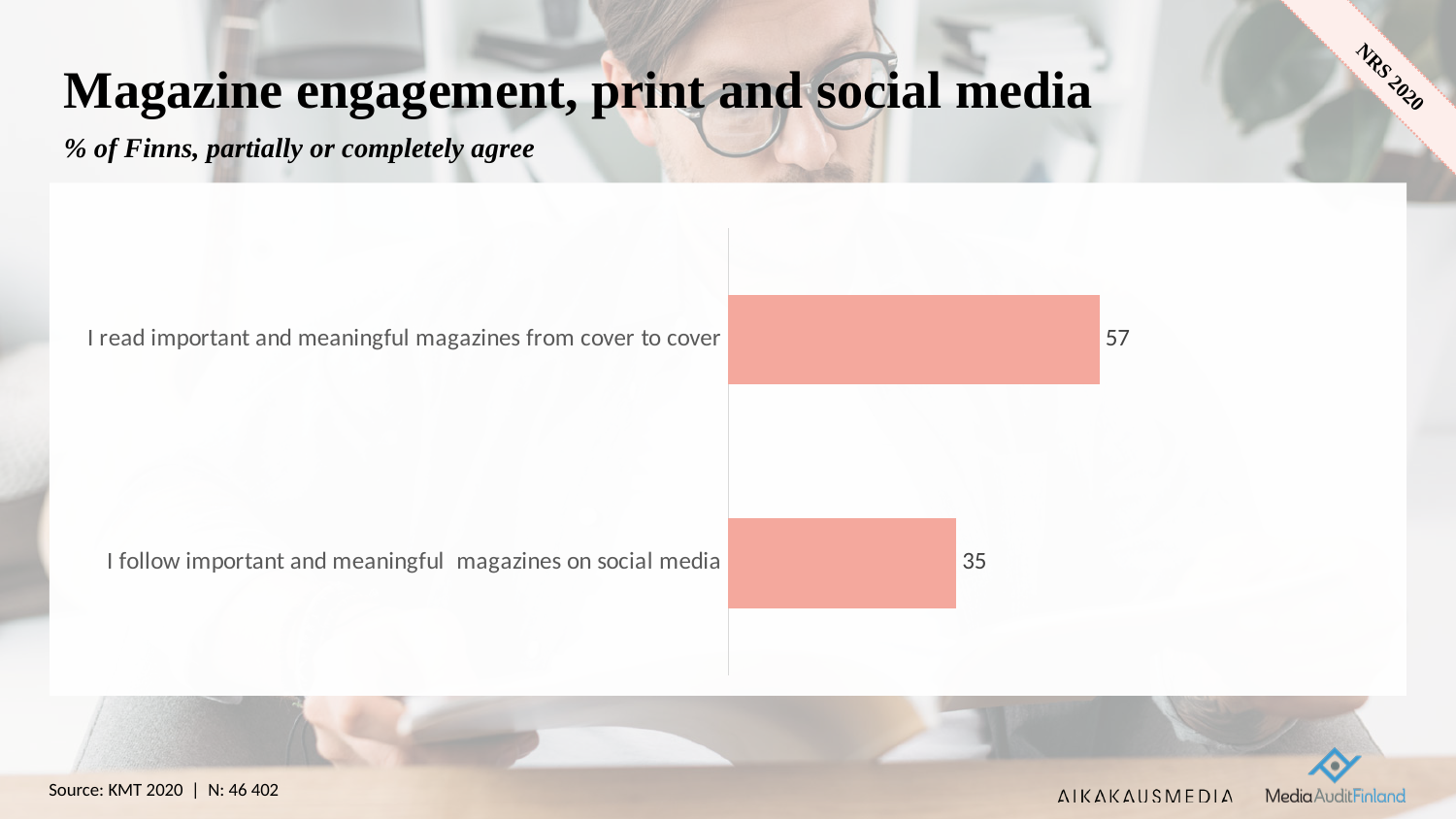
What is the title of the slide? Magazine engagement, print and social media What percentage of Finns agree with "I follow important and meaningful magazines on social media"? 35 Which statement has the lower value? I follow important and meaningful magazines on social media How many categories are shown in the chart? 2 What kind of chart is shown on the slide? bar chart What percentage of Finns agree with "I read important and meaningful magazines from cover to cover"? 57 What is the subtitle of the chart? % of Finns, partially or completely agree What is the difference between the value for reading magazines from cover to cover and the value for following magazines on social media? 22 Which statement has the higher value? I read important and meaningful magazines from cover to cover Is the value for reading magazines from cover to cover larger or smaller than the value for following magazines on social media? larger